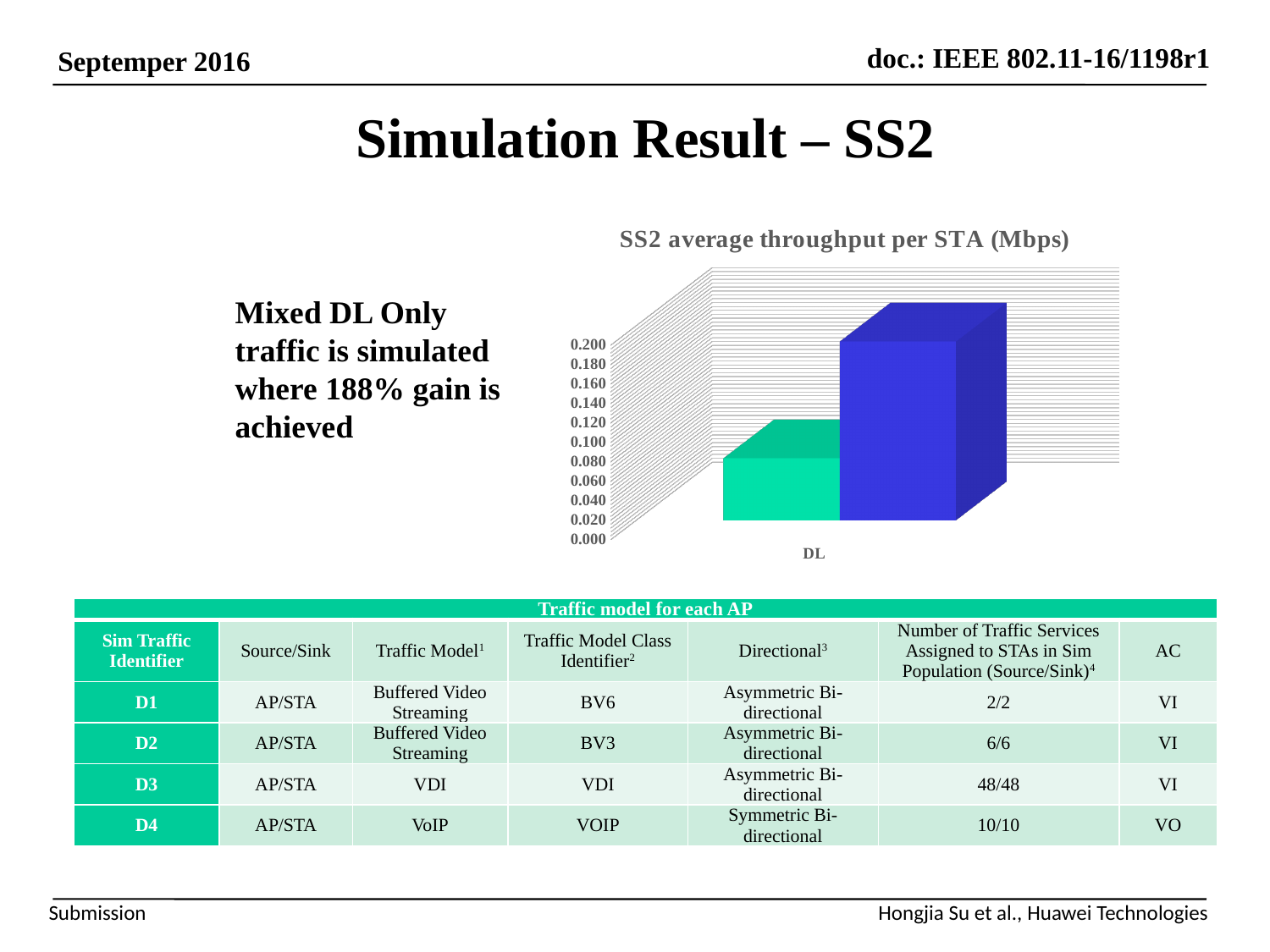
Is the value of the green bar in the chart greater or less than 0.140? less What is the highest tick value shown on the vertical axis of the chart? 0.200 Which bar is taller in the chart, the green bar or the blue bar? the blue bar Is the value of the green bar in the chart greater or less than 0.020? greater What kind of chart is shown on the slide? bar chart Is the value of the blue bar in the chart greater or less than 0.140? greater What is the label of the category on the x axis of the chart? DL How many categories are shown on the x axis of the chart? 1 How many bars are plotted in the chart? 2 What is the title of the chart? SS2 average throughput per STA (Mbps)